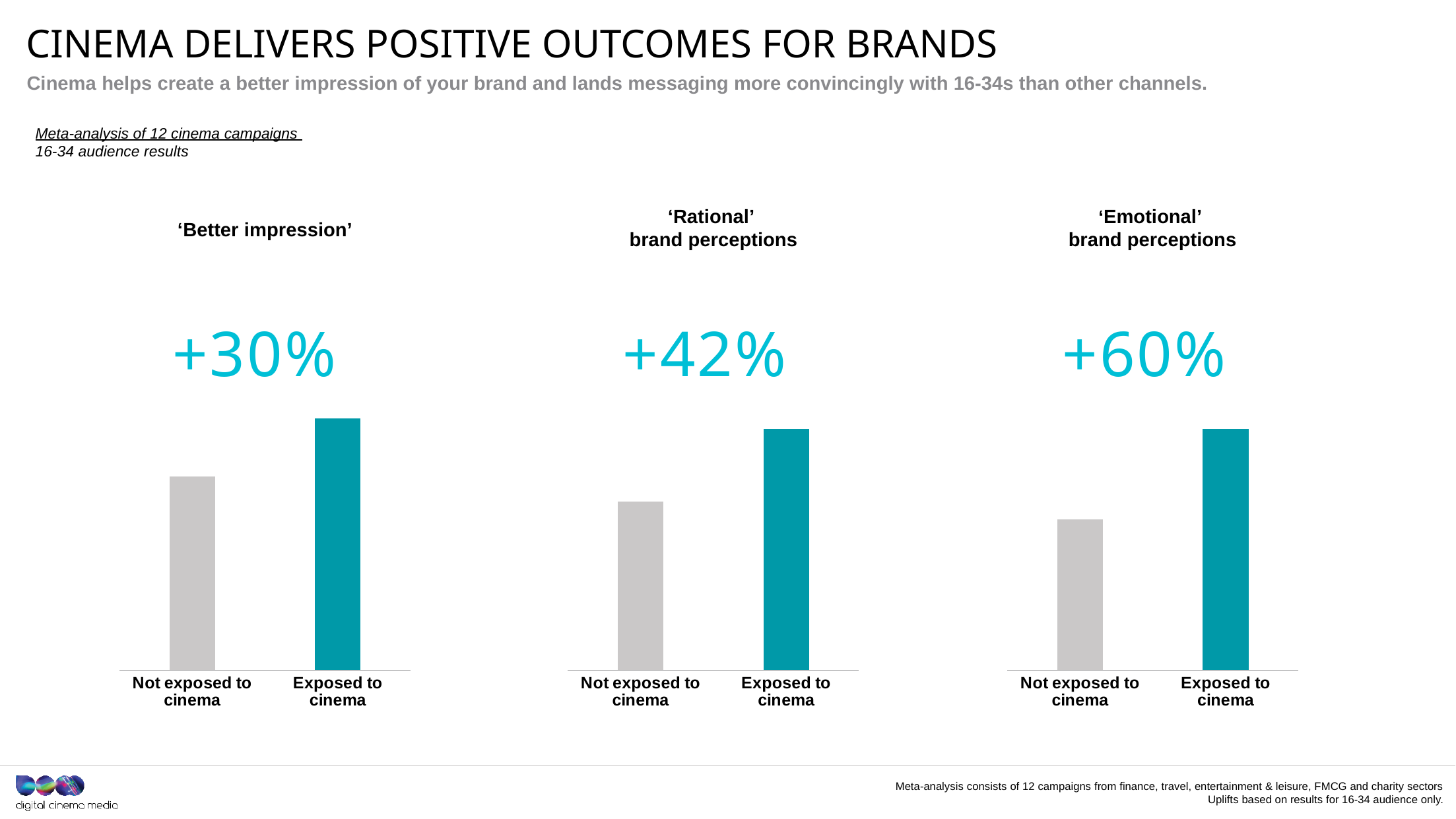
How many bar charts are shown on the slide? 3 Which of the three charts shows the smallest printed uplift figure? 'Better impression' How many categories are shown on the x axis of the 'Rational' brand perceptions chart? 2 In the 'Emotional' brand perceptions chart, do the values rise or fall from Not exposed to cinema to Exposed to cinema? rise What kind of chart is the 'Better impression' chart? bar chart Which of the three charts shows the largest printed uplift figure? 'Emotional' brand perceptions In the 'Emotional' brand perceptions chart, which category has the lowest bar? Not exposed to cinema In the 'Better impression' chart, which category has the highest bar? Exposed to cinema What uplift figure is printed above the 'Emotional' brand perceptions chart? +60% In the 'Rational' brand perceptions chart, which category has the highest bar? Exposed to cinema What uplift figure is printed above the 'Better impression' chart? +30% In the 'Rational' brand perceptions chart, which is larger: the bar for Not exposed to cinema or the bar for Exposed to cinema? Exposed to cinema